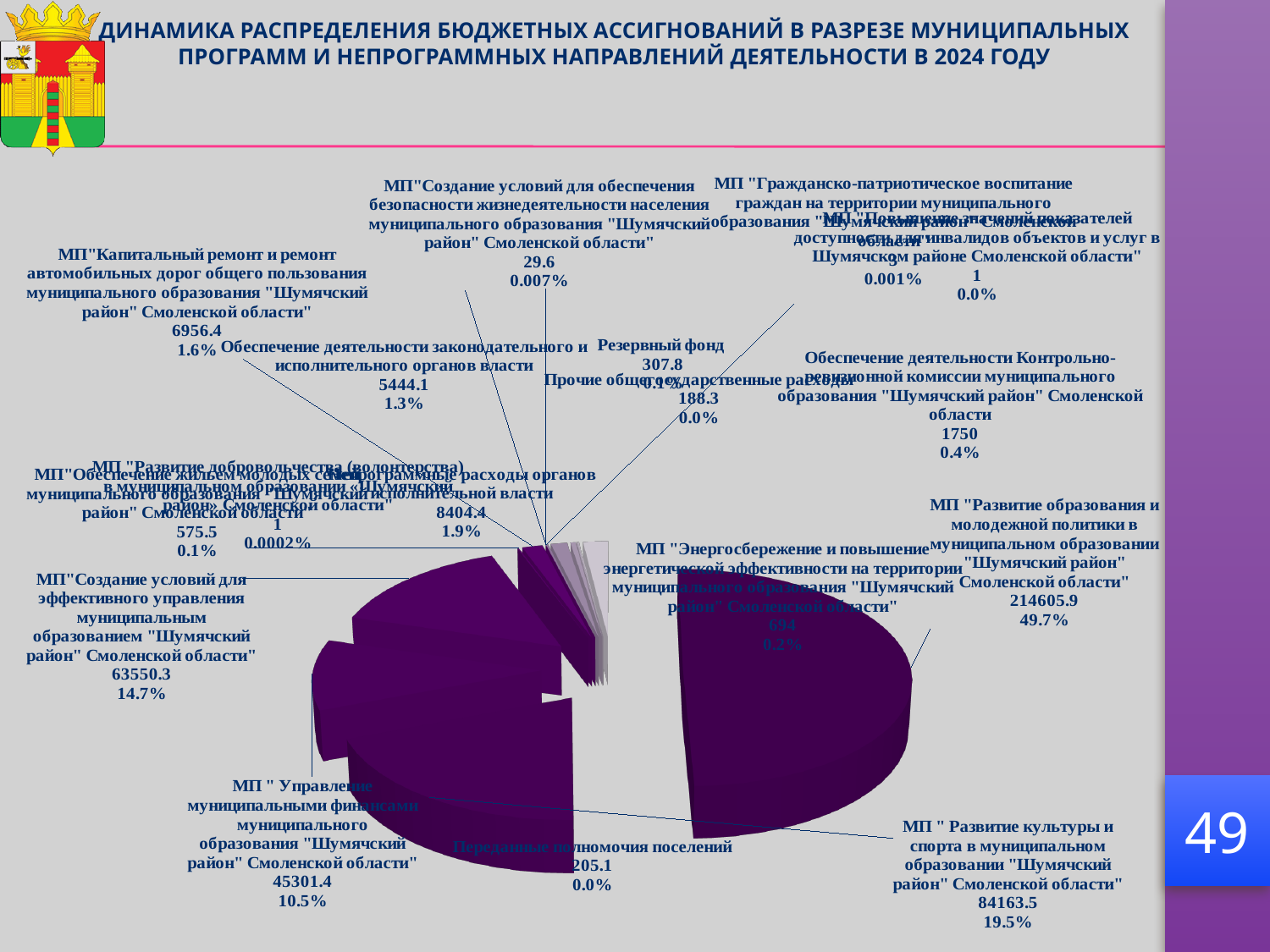
What share of the pie does МП "Капитальный ремонт и ремонт автомобильных дорог" account for? 1.6% What is the value shown for МП "Управление муниципальными финансами"? 45301.4 What share of the pie does МП "Развитие культуры и спорта" account for? 19.5% What is the value shown for Резервный фонд? 307.8 What share of the pie does МП "Создание условий для эффективного управления муниципальным образованием" account for? 14.7% What is the difference between the values for МП "Развитие культуры и спорта" (84163.5) and МП "Создание условий для эффективного управления муниципальным образованием" (63550.3)? 20613.2 What kind of chart is shown on the slide? pie chart What is the value shown for Непрограммные расходы органов исполнительной власти? 8404.4 What is the value shown for МП "Развитие образования и молодежной политики"? 214605.9 Which is larger: the value for МП "Развитие культуры и спорта" or the value for МП "Управление муниципальными финансами"? МП "Развитие культуры и спорта" What is the value shown for Обеспечение деятельности Контрольно-ревизионной комиссии? 1750 Which category has the largest share of the pie? МП "Развитие образования и молодежной политики в муниципальном образовании "Шумячский район" Смоленской области"